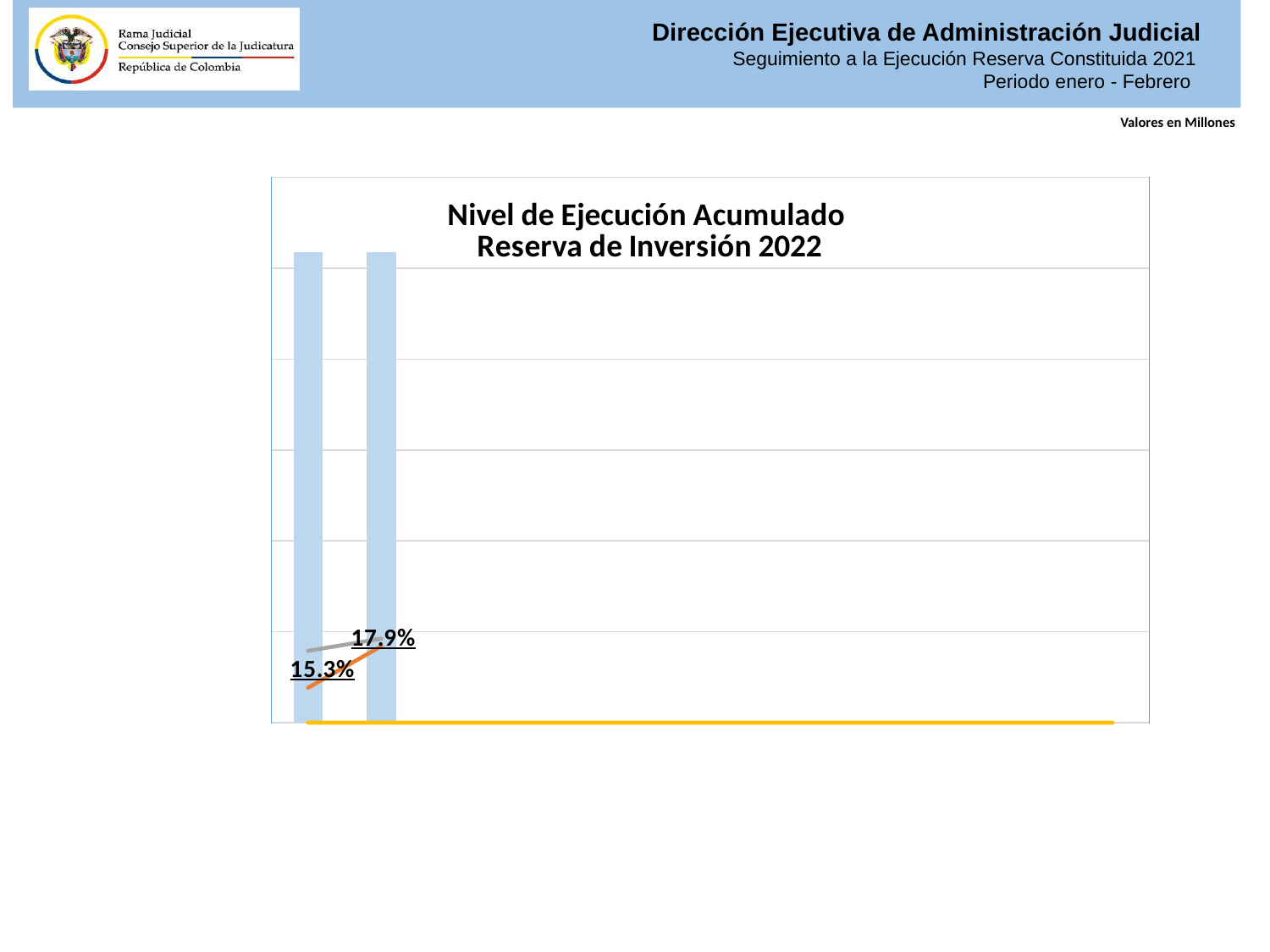
What is the difference between the two labelled percentages, 17.9% and 15.3%? 2.6 percentage points How many bars are drawn in the chart? 2 How many data points are labelled on the line in the chart? 2 Do the labelled values rise or fall from left to right? rise What is the lowest percentage labelled on the chart? 15.3% What is the value of the second labelled point on the line? 17.9% What is the value of the first (leftmost) labelled point on the line? 15.3% What is the title of the chart? Nivel de Ejecución Acumulado Reserva de Inversión 2022 What colour are the bars in the chart? light blue Which labelled value is larger, the first point or the second point? the second point (17.9%) What is the highest percentage labelled on the chart? 17.9%